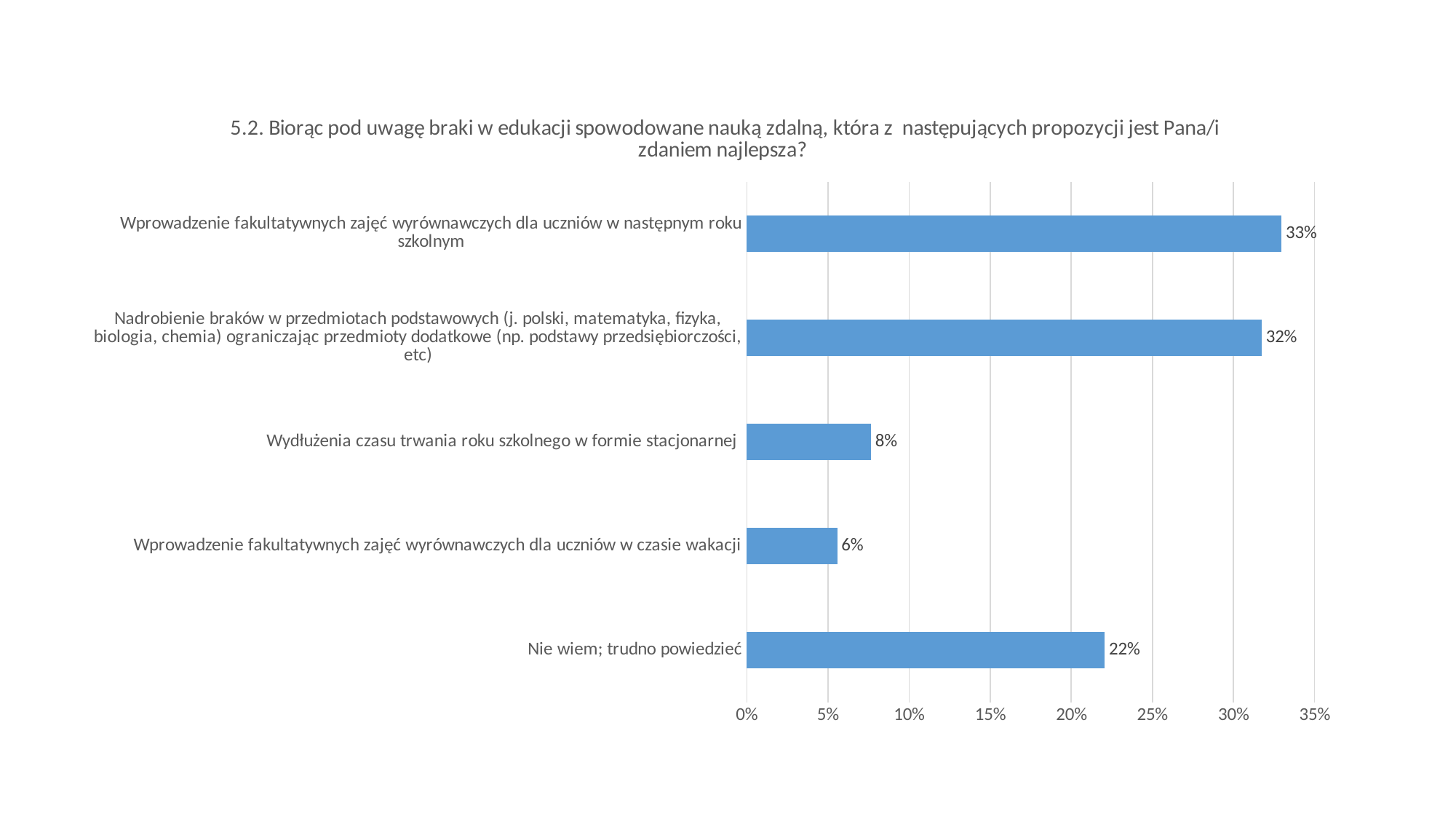
What type of chart is shown on the slide? bar chart What value is shown for "Wprowadzenie fakultatywnych zajęć wyrównawczych dla uczniów w czasie wakacji"? 6% Is the value for "Nadrobienie braków w przedmiotach podstawowych (j. polski, matematyka, fizyka, biologia, chemia) ograniczając przedmioty dodatkowe (np. podstawy przedsiębiorczości, etc)" greater or less than 30%? greater What is the difference between the value for "Nie wiem; trudno powiedzieć" and the value for "Wydłużenia czasu trwania roku szkolnego w formie stacjonarnej"? 14% What is the maximum value shown on the horizontal axis? 35% What value is shown for "Wprowadzenie fakultatywnych zajęć wyrównawczych dla uczniów w następnym roku szkolnym"? 33% What value is shown for "Nie wiem; trudno powiedzieć"? 22% Which category has the highest value? Wprowadzenie fakultatywnych zajęć wyrównawczych dla uczniów w następnym roku szkolnym How many categories are shown in the chart? 5 What value is shown for "Wydłużenia czasu trwania roku szkolnego w formie stacjonarnej"? 8% Which is larger: the value for "Nie wiem; trudno powiedzieć" or the value for "Wydłużenia czasu trwania roku szkolnego w formie stacjonarnej"? Nie wiem; trudno powiedzieć Which category has the lowest value? Wprowadzenie fakultatywnych zajęć wyrównawczych dla uczniów w czasie wakacji